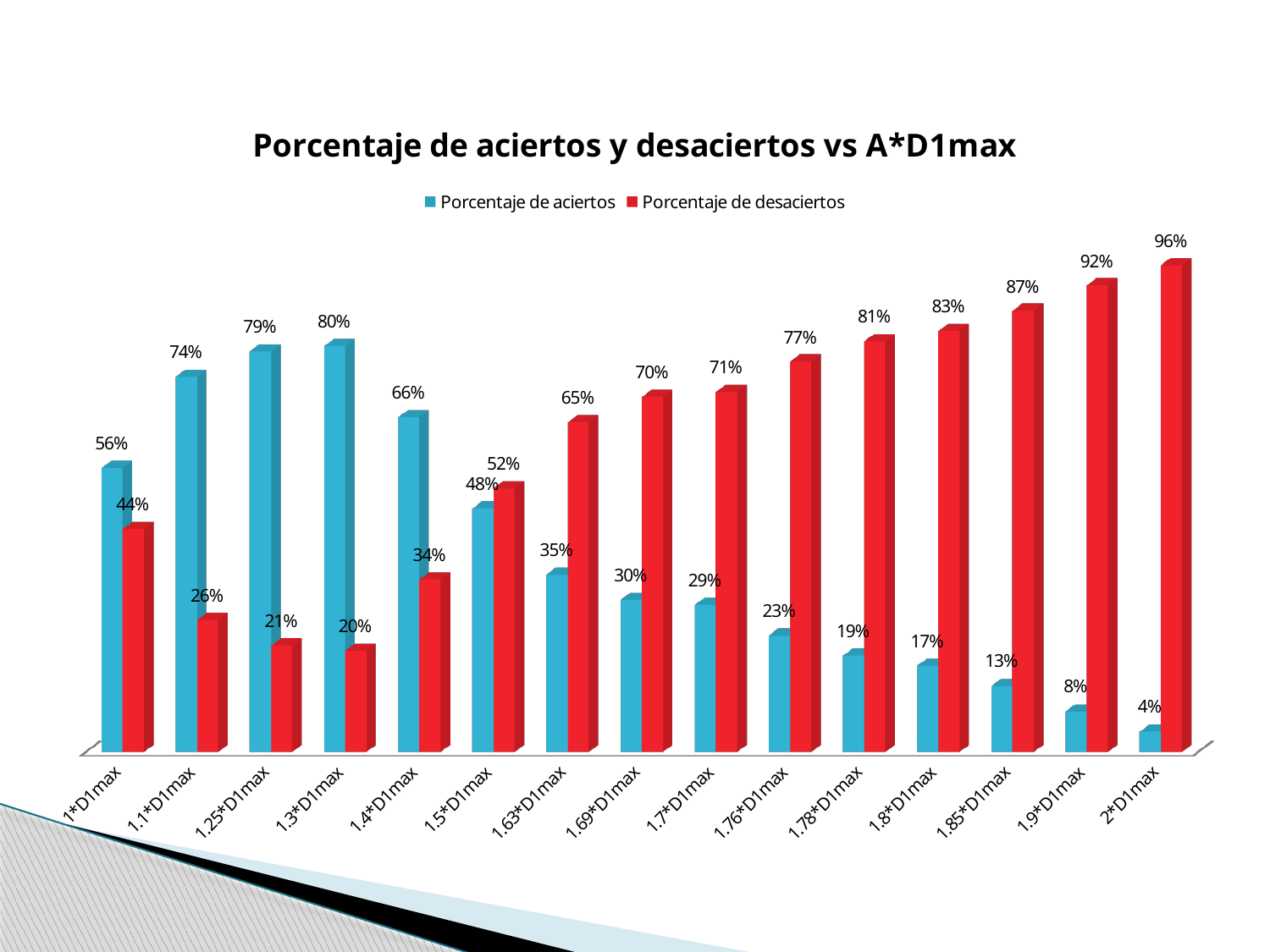
Does the Porcentaje de desaciertos rise or fall from 1.5*D1max to 2*D1max? Rise What kind of chart is shown on the slide? Bar chart Which category has the highest Porcentaje de aciertos? 1.3*D1max What is the Porcentaje de desaciertos for 1.5*D1max? 52% What is the Porcentaje de aciertos for 1.3*D1max? 80% For 1*D1max, which is larger: Porcentaje de aciertos or Porcentaje de desaciertos? Porcentaje de aciertos How many series does the legend list? 2 Which category has the lowest Porcentaje de aciertos? 2*D1max How many categories are shown on the x axis? 15 What is the difference between the Porcentaje de desaciertos and the Porcentaje de aciertos for 1.85*D1max? 74% What is the Porcentaje de aciertos for 1.76*D1max? 23% Which category has the highest Porcentaje de desaciertos? 2*D1max